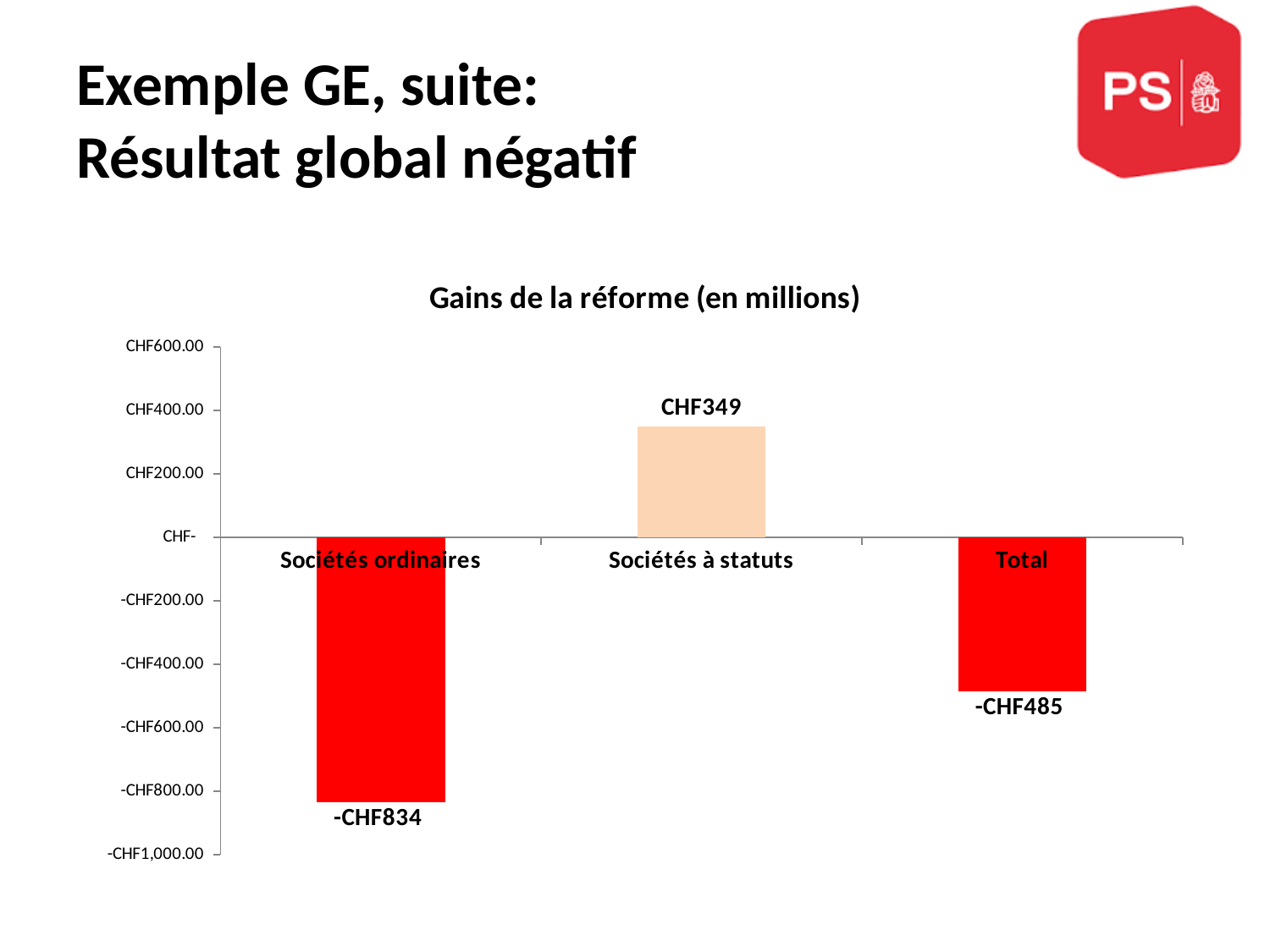
Which is larger, the value for Sociétés ordinaires or the value for Total? Total What kind of chart is shown on the slide? bar chart What is the difference between the values for Sociétés à statuts and Total? CHF834 Is the value for Sociétés à statuts greater or less than CHF400.00? less Which category has the highest value? Sociétés à statuts What colour is the bar for Sociétés à statuts? light orange What is the value for Sociétés ordinaires? -CHF834 What is the value for Total? -CHF485 What is the value for Sociétés à statuts? CHF349 What is the title of the chart? Gains de la réforme (en millions) How many categories are shown in the chart? 3 Which category has the lowest value? Sociétés ordinaires